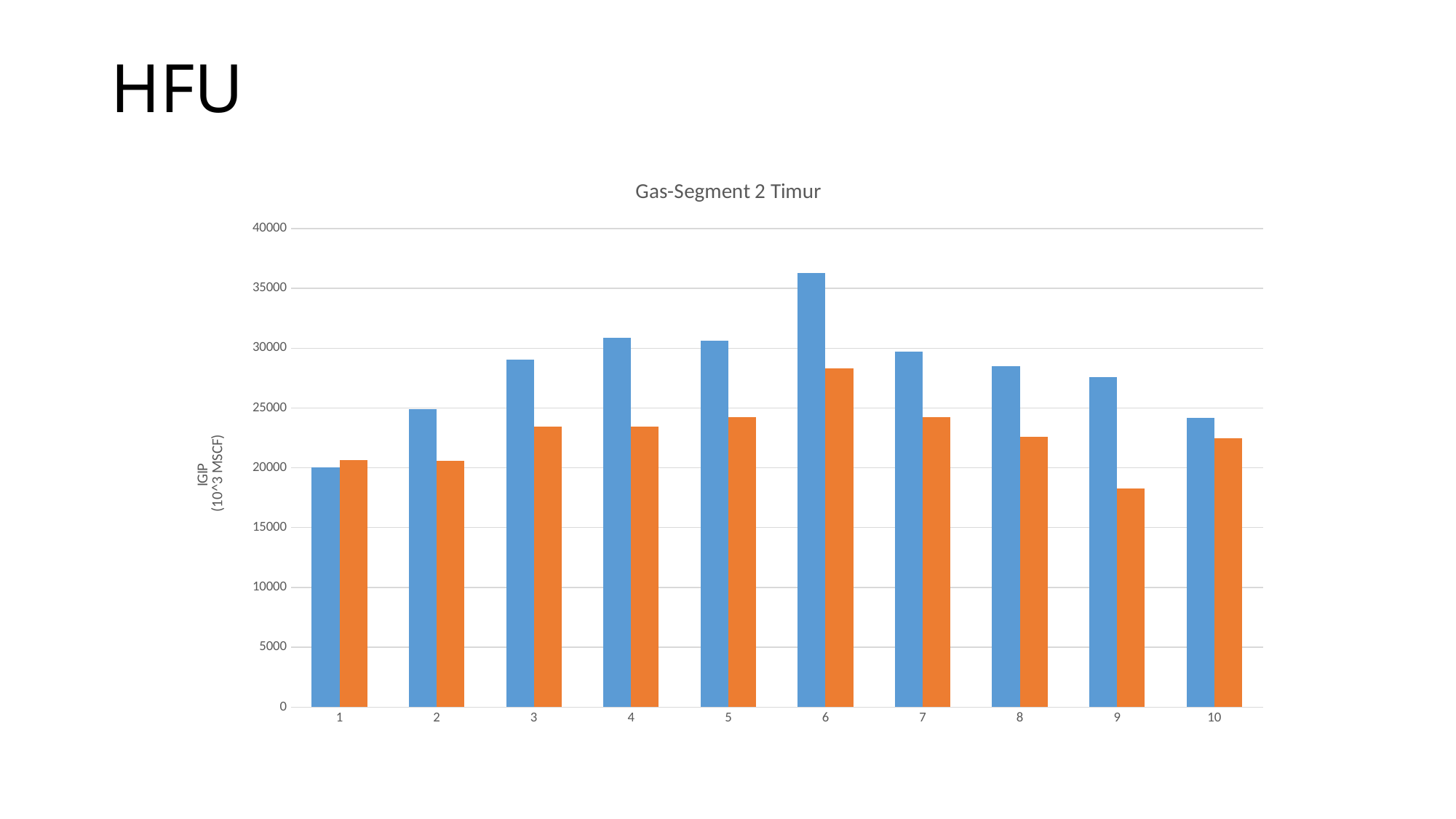
What is the label of the y axis? IGIP (10^3 MSCF) For which category is the orange bar the lowest? 9 What is the title of the chart? Gas-Segment 2 Timur For which category is the blue bar the lowest? 1 Which is larger for category 6, the blue bar or the orange bar? the blue bar Is the value of the blue bar for category 6 greater or less than 35000? greater Do the blue bars rise or fall from category 6 to category 10? fall What kind of chart is shown on the slide? bar chart For which category is the blue bar the highest? 6 For which category is the orange bar the highest? 6 How many categories are shown on the x axis of the chart? 10 Is the value of the orange bar for category 9 greater or less than 20000? less